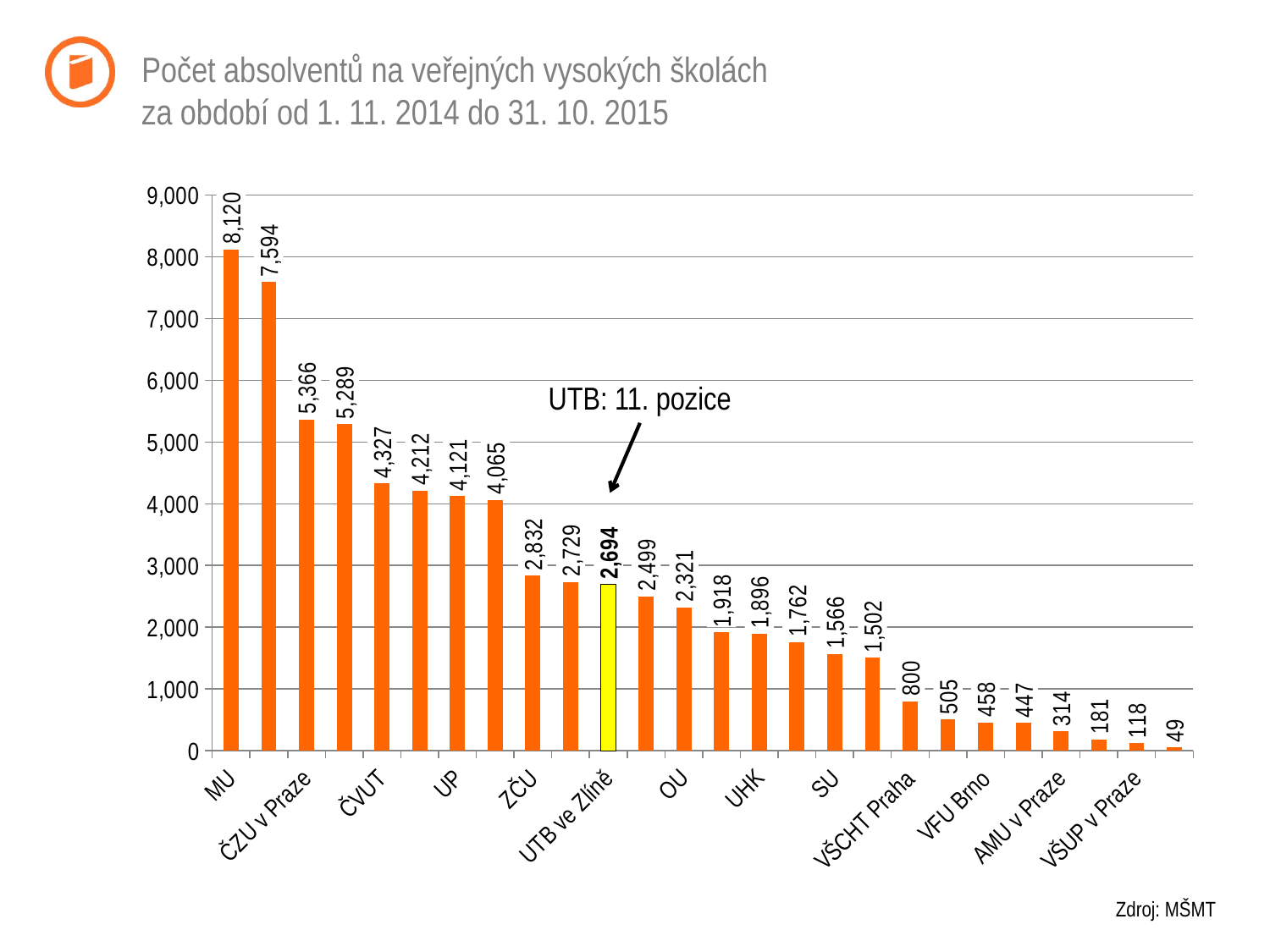
What is the value for UTB ve Zlíně? 2,694 What is the lowest value shown on the chart? 49 Which is larger, the value for ČVUT or the value for UP? ČVUT What kind of chart is shown on the slide? bar chart What is the difference between the values for MU and ČZU v Praze? 2,754 What is the difference between the values for UTB ve Zlíně and OU? 373 What is the value for VŠCHT Praha? 800 Do the values rise or fall from left to right along the x axis? fall What is the value for MU? 8,120 Is the value for UHK greater or less than 2,000? less Which category has the highest value? MU How many bars are plotted on the chart? 26